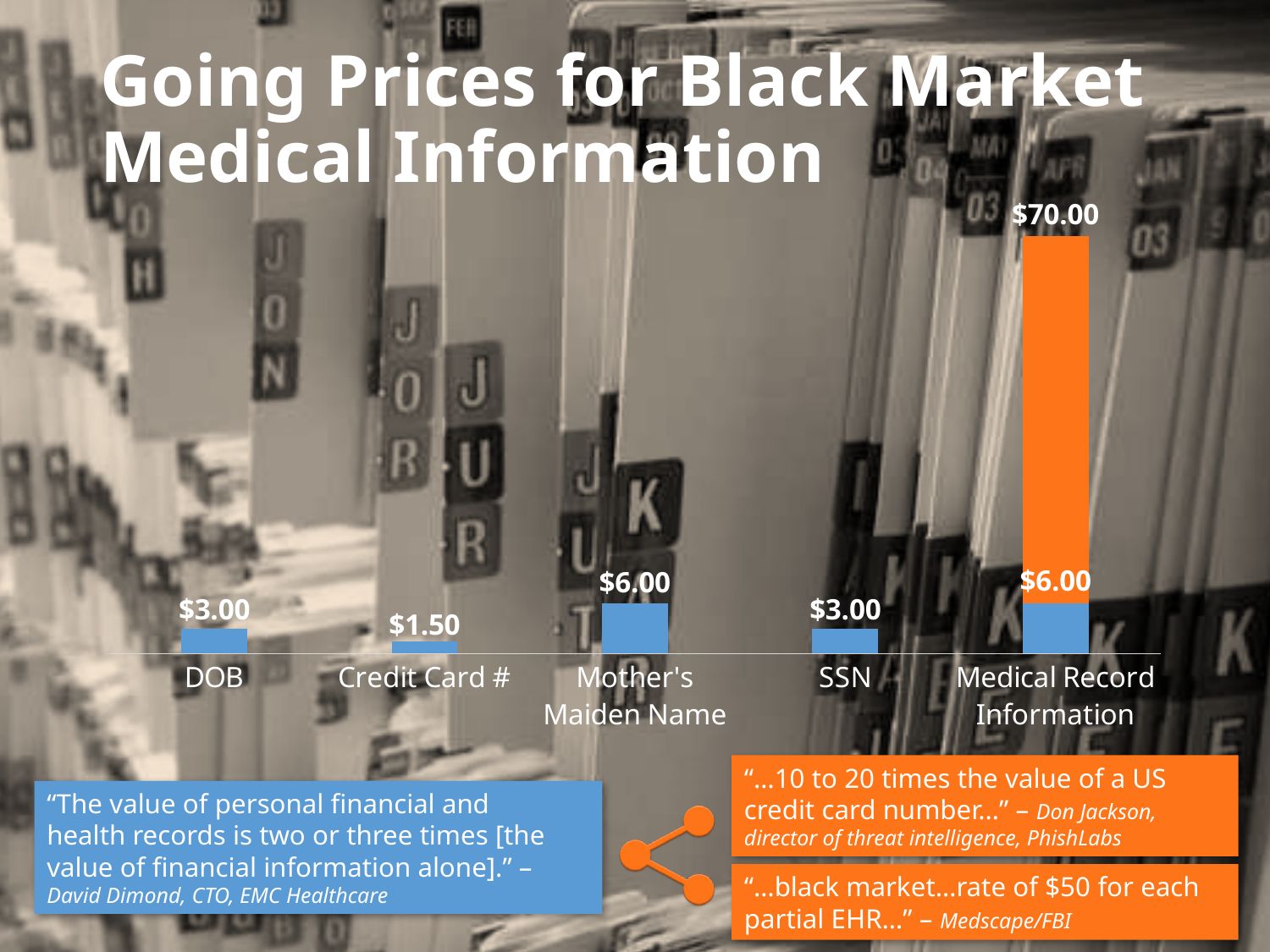
What is the value shown for DOB? $3.00 What value is labelled on the orange bar segment for Medical Record Information? $70.00 What is the value shown for Credit Card #? $1.50 Which category has the tallest bar? Medical Record Information What is the value shown for SSN? $3.00 What is the title of the slide containing the chart? Going Prices for Black Market Medical Information How many categories are shown on the x axis? 5 Which category has the lowest value? Credit Card # What is the difference between the values for Mother's Maiden Name and Credit Card #? $4.50 Which is larger, the value for Mother's Maiden Name or the value for SSN? Mother's Maiden Name What is the value shown for Mother's Maiden Name? $6.00 What kind of chart is shown on the slide? Bar chart